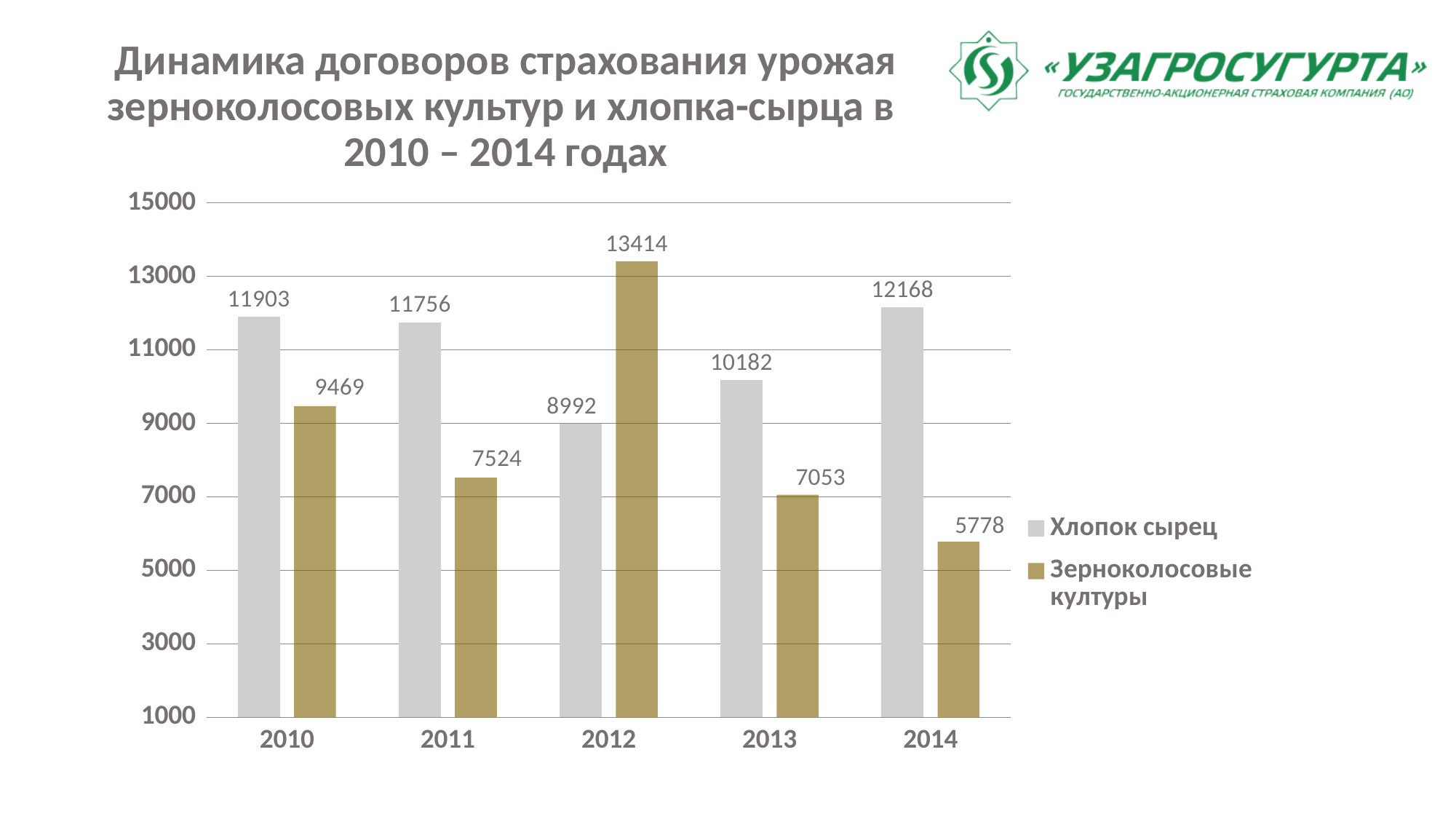
Which colour represents Хлопок сырец in the chart? grey Is the value for Зерноколосовые культуры in 2013 greater or less than 9000? less Which is larger in 2012: Хлопок сырец or Зерноколосовые культуры? Зерноколосовые культуры What is the value for Хлопок сырец in 2012? 8992 How many years are shown on the x axis? 5 What is the difference between Хлопок сырец and Зерноколосовые культуры in 2010? 2434 In which year is the value for Зерноколосовые культуры highest? 2012 What is the value for Зерноколосовые культуры in 2014? 5778 Does the value for Зерноколосовые культуры rise or fall from 2012 to 2014? fall What kind of chart is shown on the slide? bar chart How many series does the legend list? 2 In which year is the value for Хлопок сырец lowest? 2012